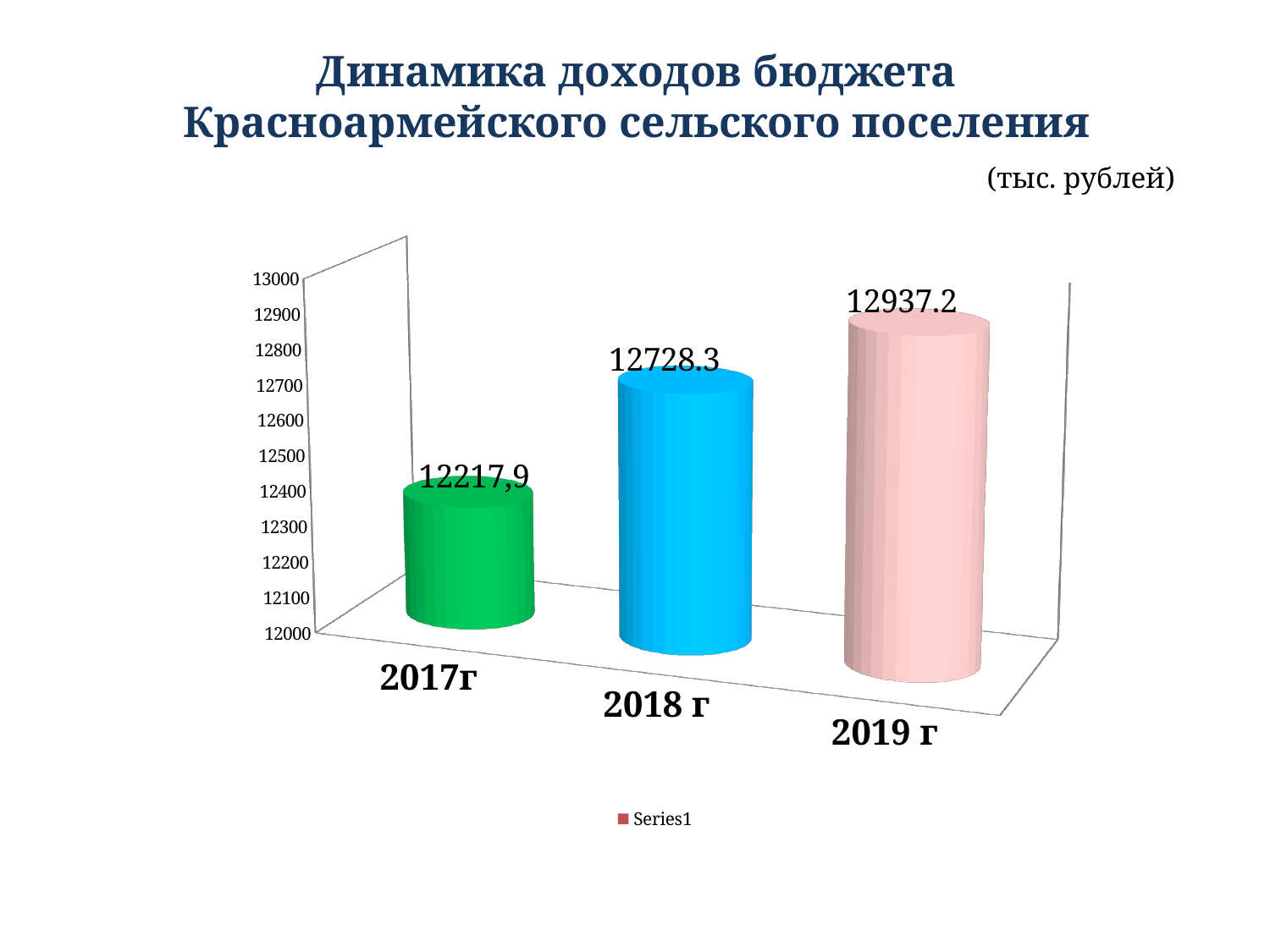
Which is larger, the value for 2017г or the value for 2018 г? 2018 г Is the value for 2019 г greater or less than 12900? greater Which year has the highest value? 2019 г What is the value for 2019 г? 12937.2 Do the values rise or fall from 2017г to 2019 г? rise How many categories are shown on the x axis? 3 What kind of chart is shown on the slide? bar chart Which year has the lowest value? 2017г What is the value for 2018 г? 12728.3 What is the difference between the values for 2018 г and 2017г? 510.4 What is the value for 2017г? 12217,9 What is the difference between the values for 2019 г and 2018 г? 208.9